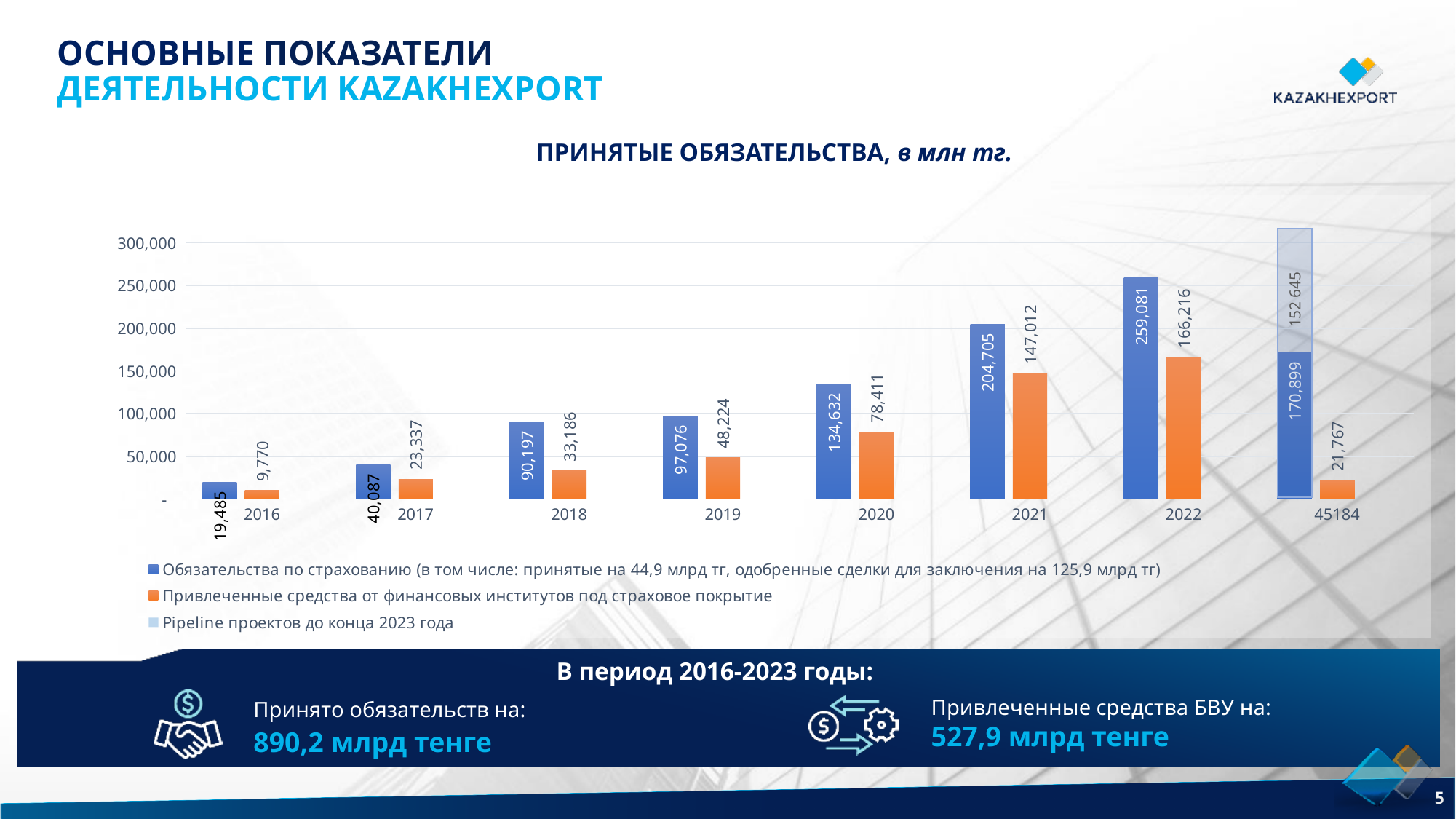
What is the value of Pipeline проектов до конца 2023 года in the category labelled 45184? 152 645 What is the value of Привлеченные средства от финансовых институтов под страховое покрытие for 2019? 48,224 What type of chart is shown on the slide? bar chart How many series does the legend list? 3 What is the value of Обязательства по страхованию for 2020? 134,632 Which is larger in 2021: Обязательства по страхованию or Привлеченные средства от финансовых институтов? Обязательства по страхованию In which year is Привлеченные средства от финансовых институтов под страховое покрытие lowest? 2016 In which year is Обязательства по страхованию highest? 2022 Does Обязательства по страхованию rise or fall from 2016 to 2022? rise What is the difference between Обязательства по страхованию and Привлеченные средства от финансовых институтов in 2022? 92,865 How many categories are shown on the x axis? 8 What is the total of the stacked bar in the category labelled 45184 (Обязательства по страхованию plus Pipeline проектов)? 323,544